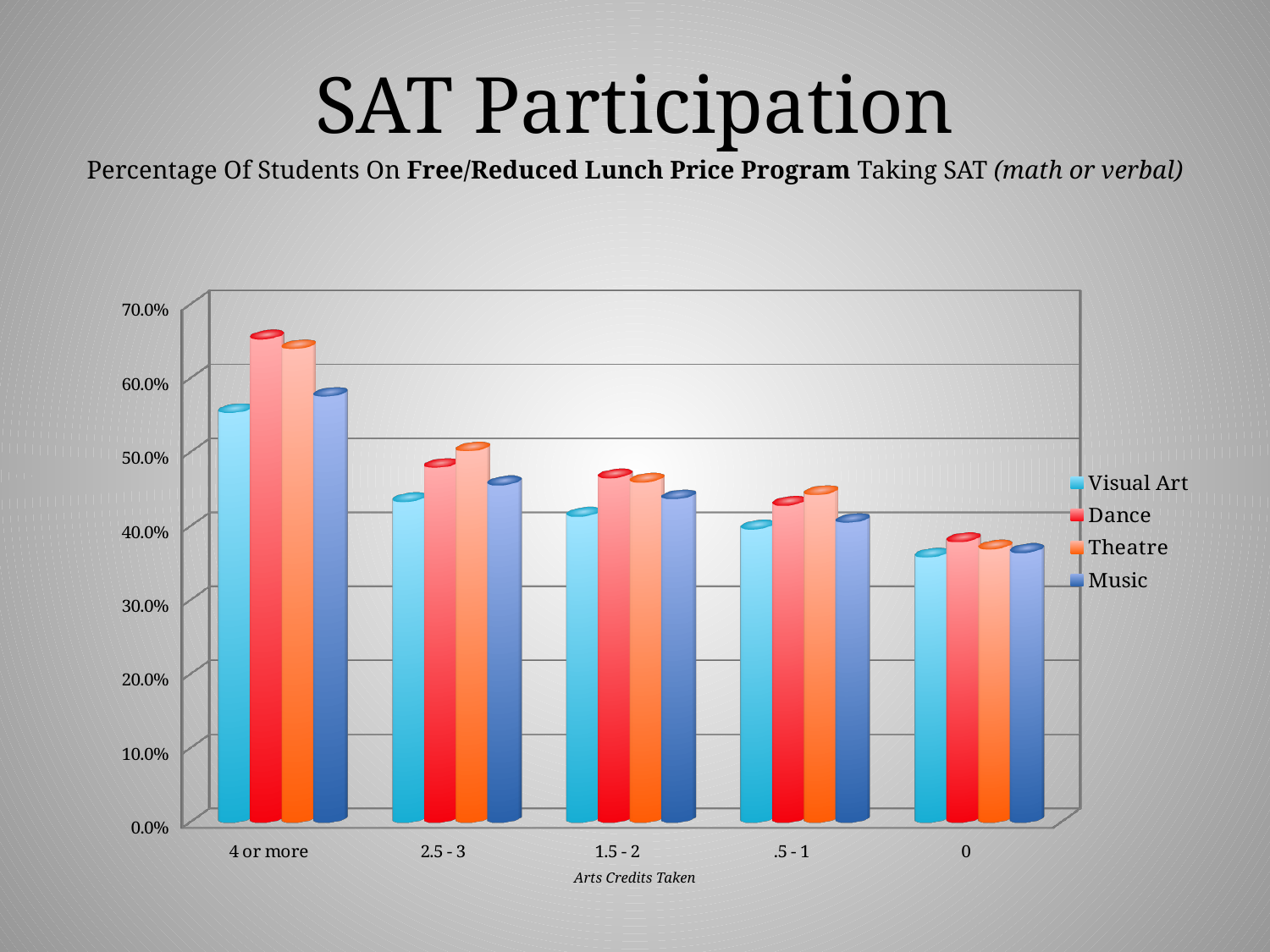
Is the Dance value for '0' greater or less than 40.0%? less For the Dance series, which category has the highest value? 4 or more How many categories are shown along the x axis? 5 In the '.5 - 1' category, which is larger: Theatre or Visual Art? Theatre What is the title of the x axis? Arts Credits Taken How many series does the legend list? 4 Is the Visual Art value for '4 or more' greater or less than 50.0%? greater Is the Music value for '2.5 - 3' greater or less than 50.0%? less For the Visual Art series, which category has the lowest value? 0 What kind of chart is shown on the slide? bar chart In the '4 or more' category, which is larger: Dance or Visual Art? Dance Do the Visual Art values rise or fall as you move from '4 or more' to '0' along the x axis? fall